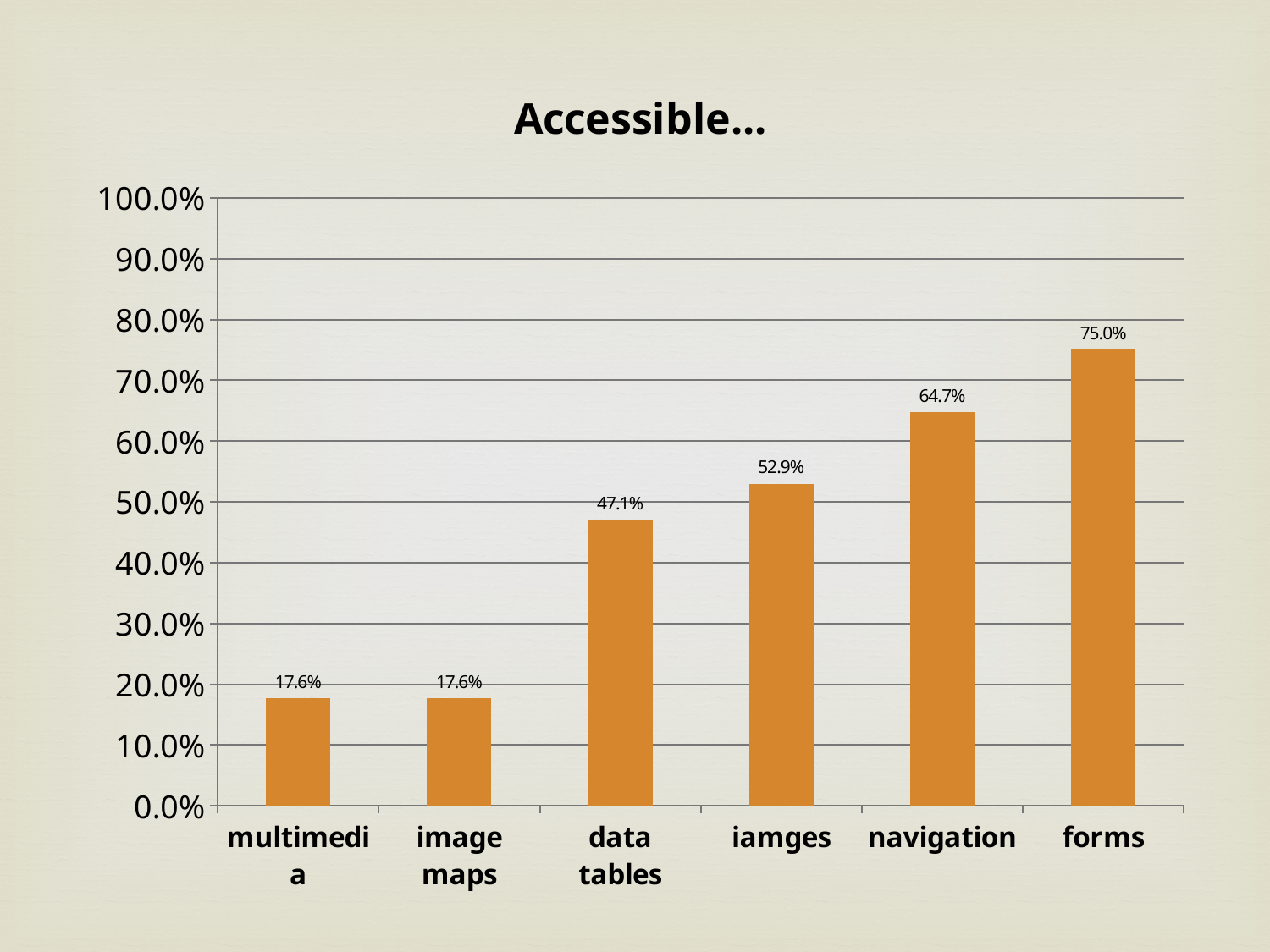
What is the difference between the values for forms and navigation? 10.3% Which is larger, the value for iamges or the value for data tables? iamges How many categories are shown on the x axis? 6 What is the value for data tables? 47.1% What kind of chart is shown on the slide? bar chart What is the value for forms? 75.0% Is the value for navigation greater or less than 60.0%? greater What is the value for multimedia? 17.6% What is the value for navigation? 64.7% What is the difference between the values for iamges and data tables? 5.8% What is the title of the chart? Accessible… Which category has the highest value? forms